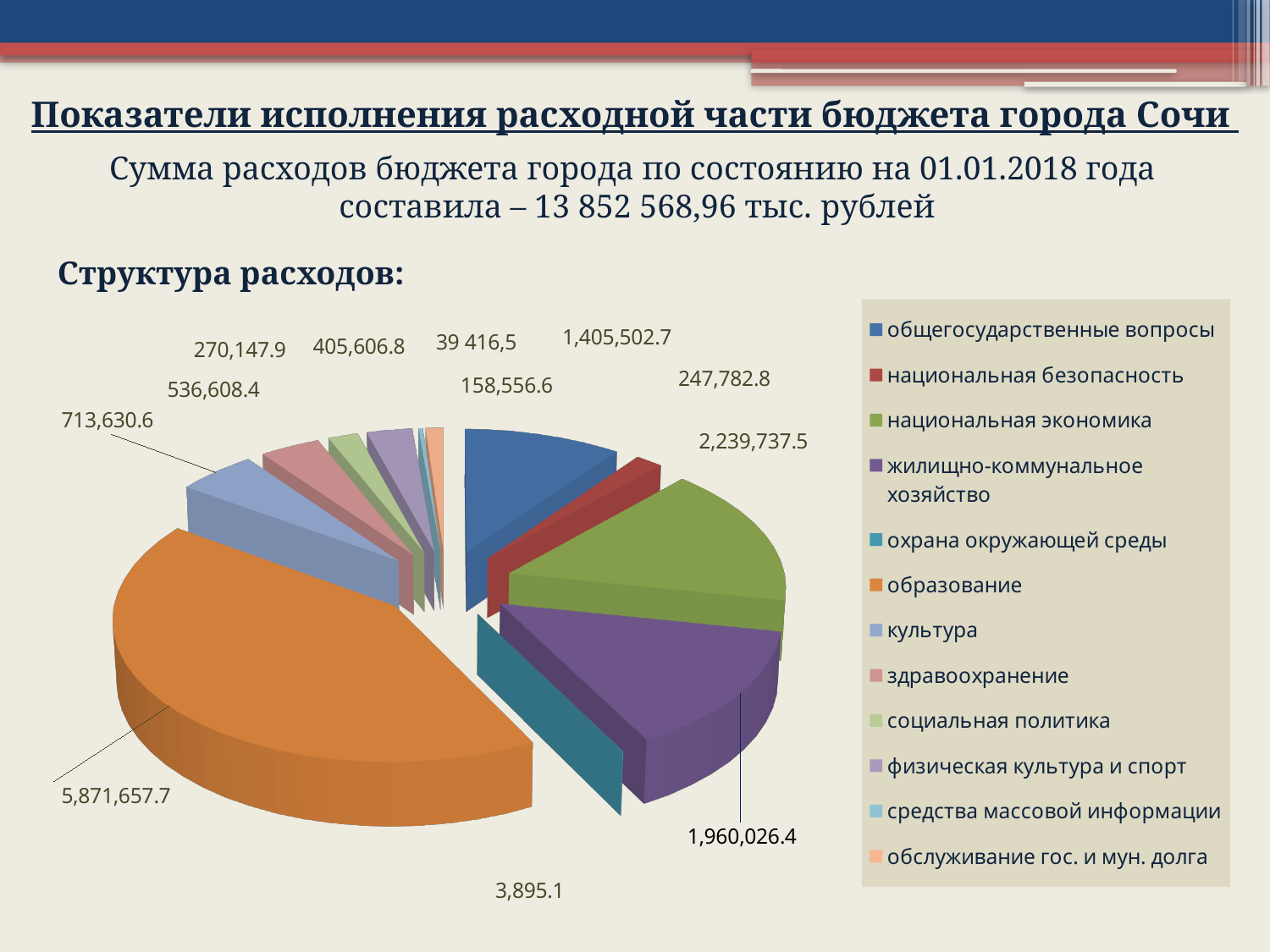
What colour is the образование slice in the pie chart? orange What is the value shown for общегосударственные вопросы in the pie chart? 1,405,502.7 What is the value shown for национальная экономика in the pie chart? 2,239,737.5 What is the value shown for образование in the pie chart? 5,871,657.7 What is the difference between the values for образование and национальная экономика in the pie chart? 3,631,920.2 What is the heading printed directly above the pie chart? Структура расходов: How many expenditure categories does the legend of the pie chart list? 12 What is the value shown for культура in the pie chart? 713,630.6 Which expenditure category has the largest slice in the pie chart? образование What is the value shown for жилищно-коммунальное хозяйство in the pie chart? 1,960,026.4 What kind of chart is shown on the slide? pie chart Which is larger in the pie chart: национальная экономика or жилищно-коммунальное хозяйство? национальная экономика